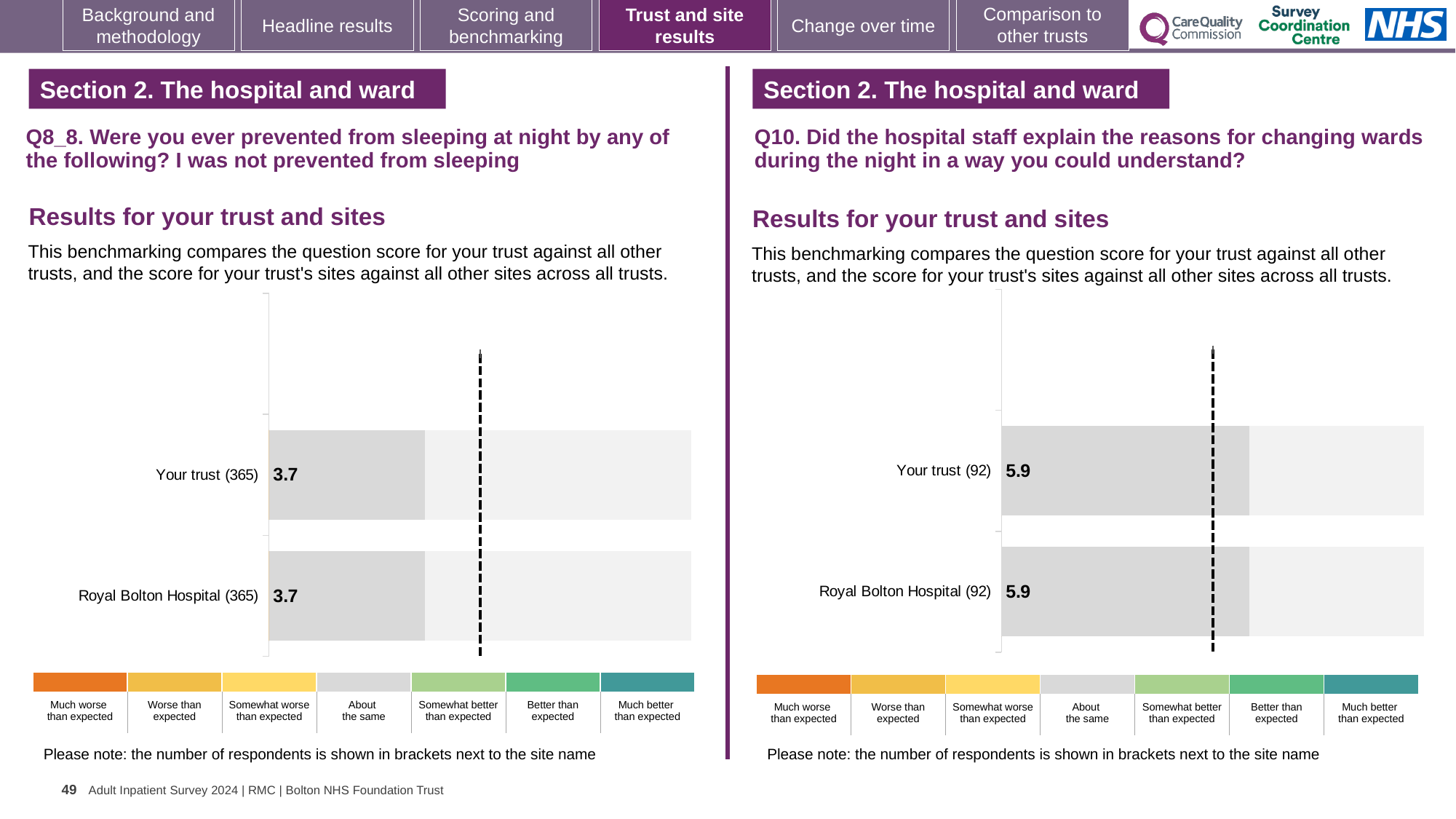
In the left chart (Q8_8), how many respondents are shown in brackets next to Your trust? 365 In the left chart (Q8_8), what is the score for Your trust? 3.7 In the left chart (Q8_8), what is the score for Royal Bolton Hospital? 3.7 What kind of chart is used in the left chart (Q8_8)? Bar chart How many bars are plotted in the left chart (Q8_8)? 2 In the right chart (Q10), what is the difference between the score for Your trust and the score for Royal Bolton Hospital? 0 In the left chart (Q8_8), what is the difference between the score for Your trust and the score for Royal Bolton Hospital? 0 In the right chart (Q10), what is the score for Your trust? 5.9 In the right chart (Q10), what is the score for Royal Bolton Hospital? 5.9 In the right chart (Q10), how many respondents are shown in brackets next to Royal Bolton Hospital? 92 How many bars are plotted in the right chart (Q10)? 2